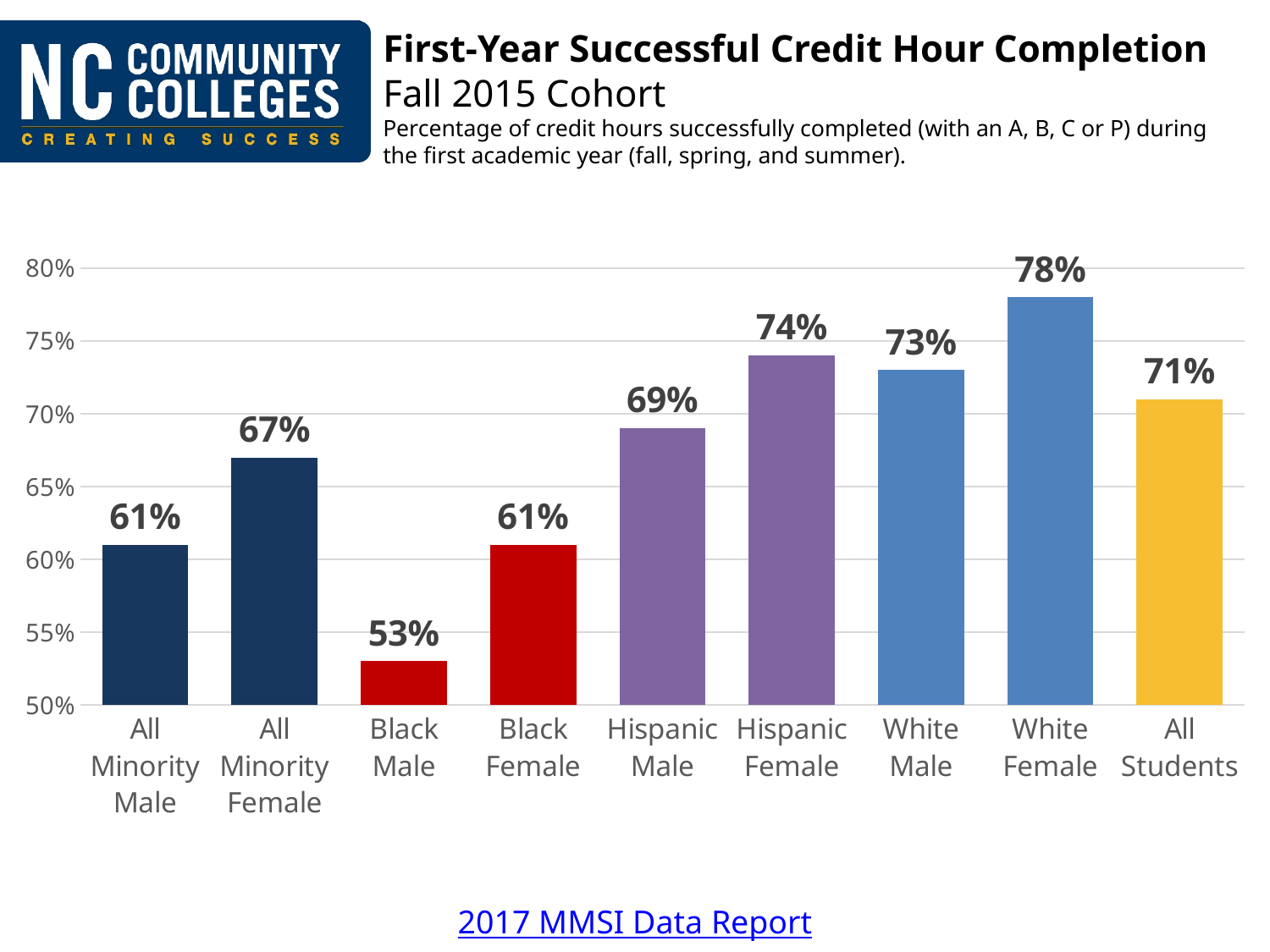
What is the difference between the White Female and Black Male percentages? 25% Which category has the highest completion percentage? White Female What kind of chart is shown on the slide? bar chart What is the difference between the All Minority Female and All Minority Male values? 6% How many categories are shown on the x axis? 9 What is the value shown for All Students? 71% Is the value for Black Female greater or less than 65%? less What is the first-year successful credit hour completion percentage for Black Male students? 53% What percentage is shown for Hispanic Female students? 74% What is the title of the chart? First-Year Successful Credit Hour Completion Which category has the lowest completion percentage? Black Male Which is larger, the value for Hispanic Male or the value for White Male? White Male